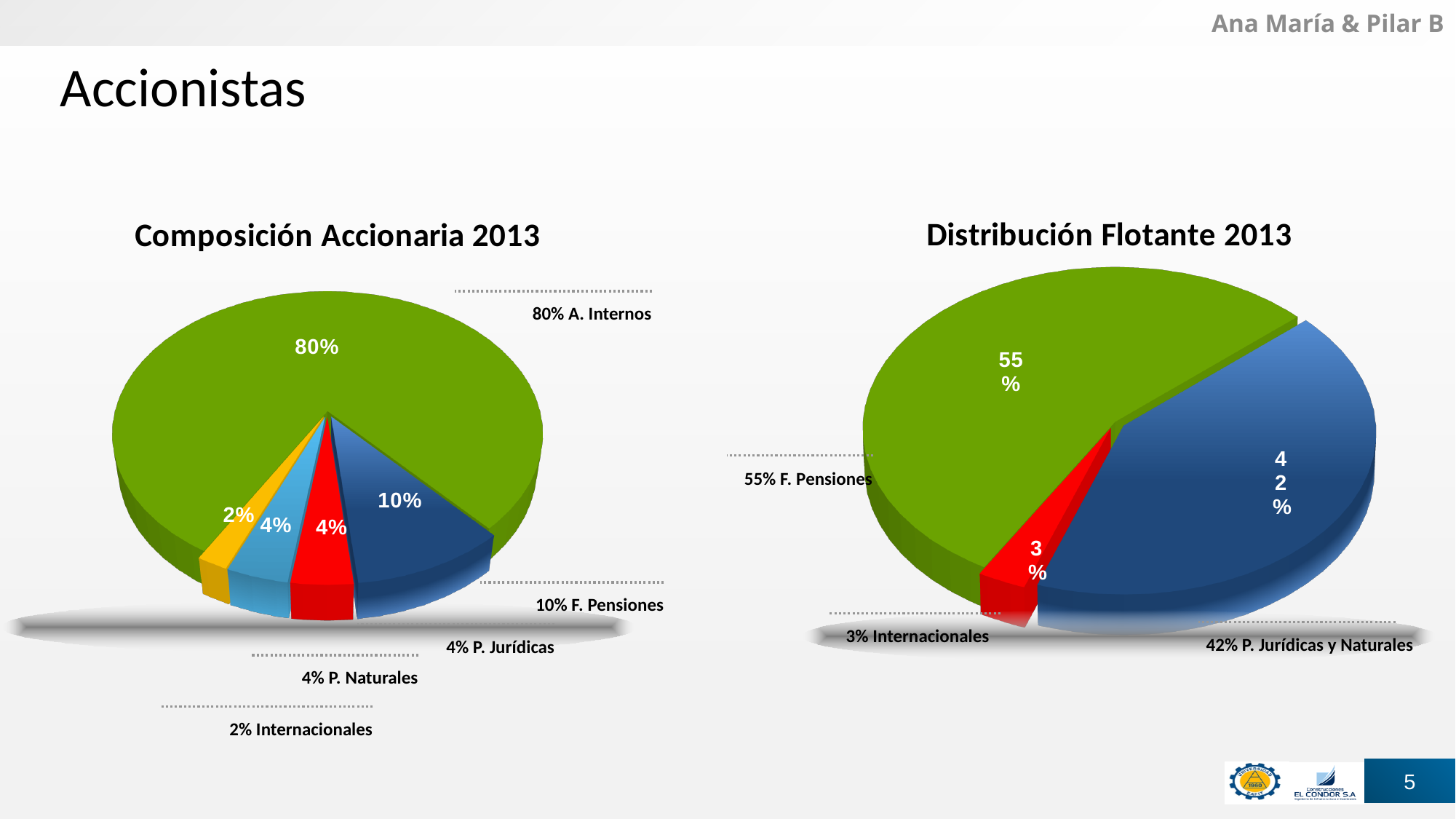
In the 'Distribución Flotante 2013' chart, which is larger: F. Pensiones or P. Jurídicas y Naturales? F. Pensiones In the 'Distribución Flotante 2013' chart, what share does F. Pensiones hold? 55% In the 'Distribución Flotante 2013' chart, which category has the smallest slice? Internacionales In the 'Distribución Flotante 2013' chart, what share do P. Jurídicas y Naturales hold? 42% In the 'Composición Accionaria 2013' chart, which category has the smallest slice? Internacionales In the 'Composición Accionaria 2013' chart, what share does A. Internos hold? 80% In the 'Composición Accionaria 2013' chart, how many slices does the pie have? 5 In the 'Composición Accionaria 2013' chart, what is the difference between the A. Internos share and the F. Pensiones share? 70% What type of chart is used for 'Distribución Flotante 2013'? Pie chart In the 'Composición Accionaria 2013' chart, what share do Internacionales hold? 2% In the 'Composición Accionaria 2013' chart, what share does F. Pensiones hold? 10% In the 'Composición Accionaria 2013' chart, which category has the largest slice? A. Internos